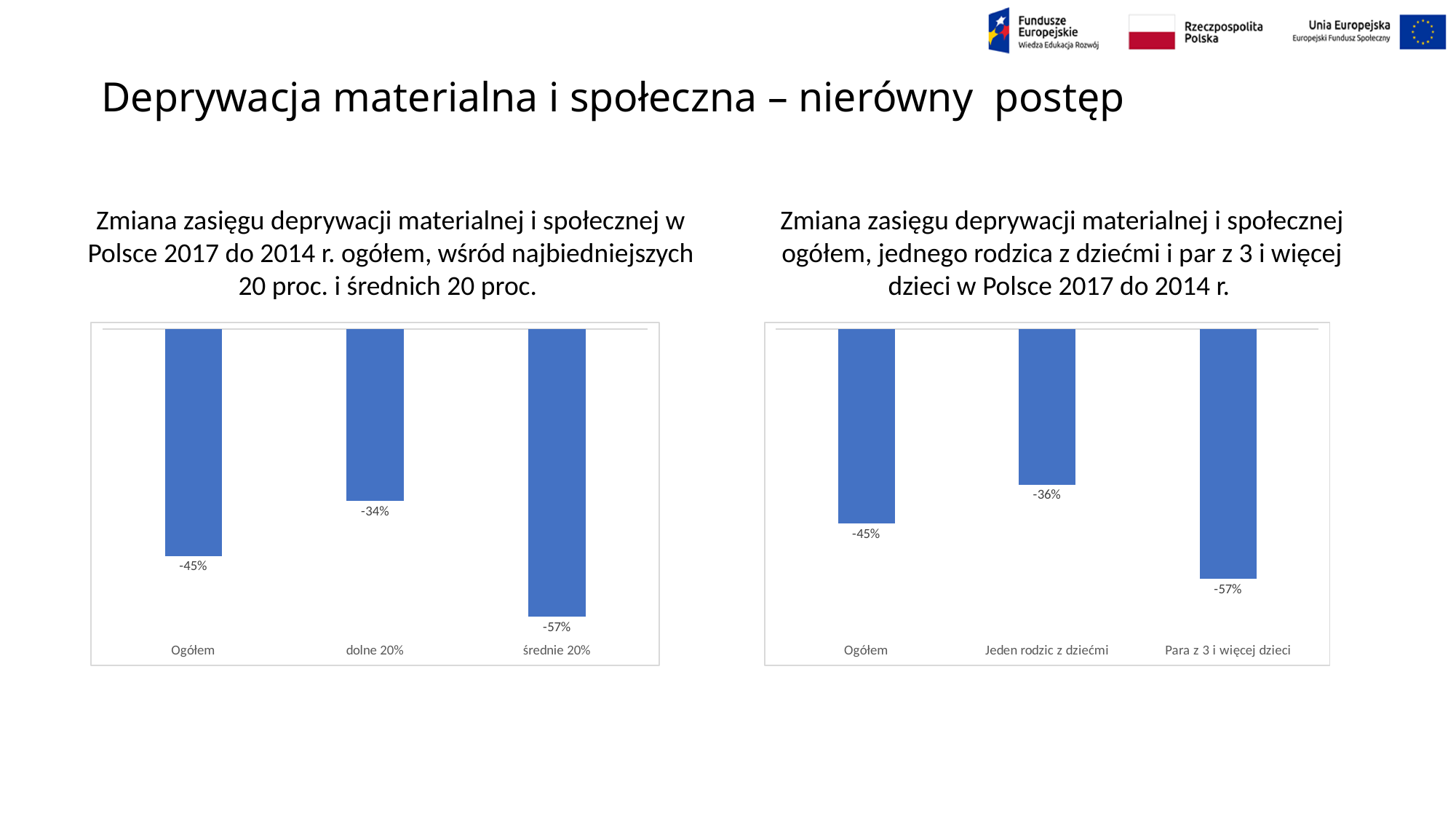
In the left chart, which category has the lowest value (largest decline)? średnie 20% In the right chart, what is the difference in percentage points between the values for Para z 3 i więcej dzieci and Ogółem? 12 percentage points In the left chart, what is the value for Ogółem? -45% In the right chart, which shows a larger decline: Ogółem or Jeden rodzic z dziećmi? Ogółem In the right chart, what is the value for Para z 3 i więcej dzieci? -57% In the right chart, which category has the highest value (smallest decline)? Jeden rodzic z dziećmi In the left chart, what is the value for dolne 20%? -34% In the right chart, what is the value for Jeden rodzic z dziećmi? -36% How many categories are shown in the right chart? 3 What type of chart is the left chart? Bar chart In the left chart, what is the value for średnie 20%? -57% In the left chart, what is the difference in percentage points between the values for Ogółem and dolne 20%? 11 percentage points